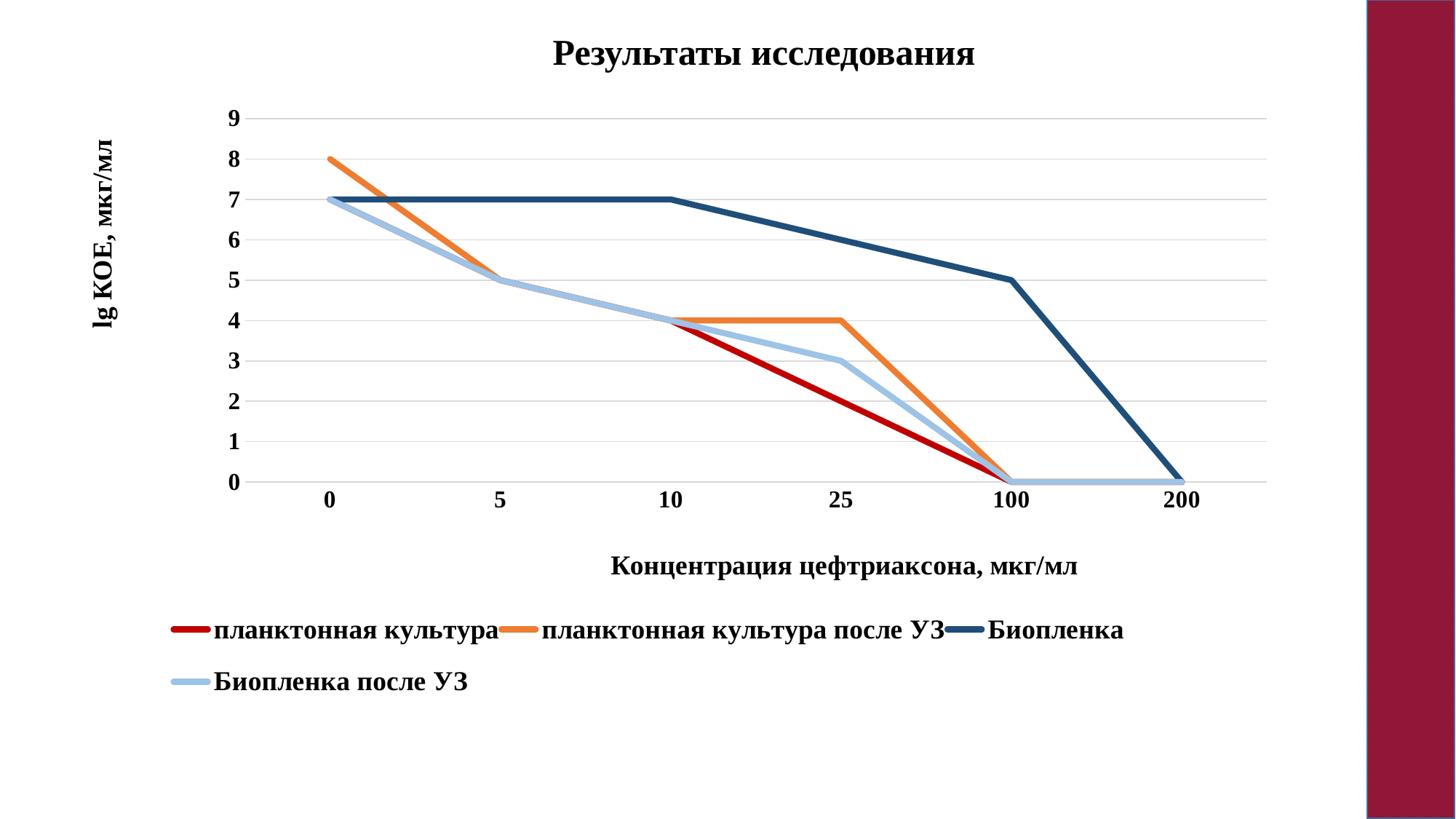
Which series has the highest value at concentration 0? планктонная культура после УЗ What is the value of 'планктонная культура после УЗ' at concentration 0? 8 How many concentration points are shown on the x axis? 6 What is the value of 'Биопленка' at concentration 100? 5 Which series has the highest value at concentration 100? Биопленка How many series does the legend list? 4 What is the value of 'Биопленка после УЗ' at concentration 25? 3 What is the difference between 'Биопленка' and 'Биопленка после УЗ' at concentration 25? 3 What is the value of 'планктонная культура после УЗ' at concentration 25? 4 What kind of chart is shown on the slide? line chart What is the title of the chart? Результаты исследования Do the values of 'Биопленка' rise or fall as the concentration increases from 10 to 200? fall